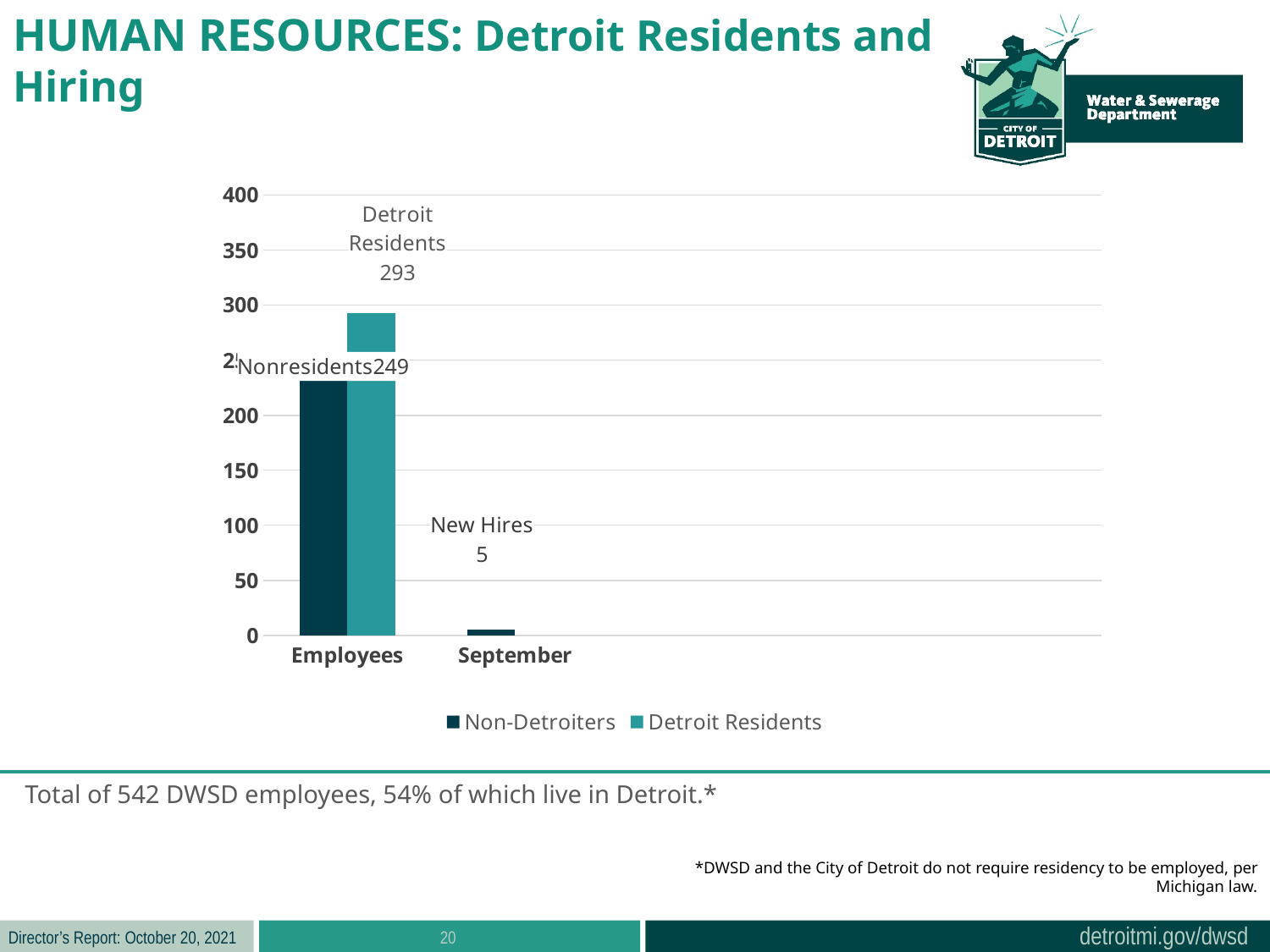
How many categories are shown on the x axis of the chart? 2 Is the New Hires bar for September greater or less than 50? less Is the Detroit Residents bar for Employees greater or less than 250? greater What is the difference between the Detroit Residents value (293) and the Nonresidents value (249) in the Employees category? 44 What is the value labelled for Nonresidents in the Employees category? 249 How many series does the chart legend list? 2 What is the value labelled for New Hires in the September category? 5 What is the highest value shown on the chart's y axis? 400 What is the value labelled for Detroit Residents in the Employees category? 293 What are the two series named in the chart legend? Non-Detroiters and Detroit Residents Which series has the taller bar in the Employees category? Detroit Residents What kind of chart is shown on the slide? bar chart